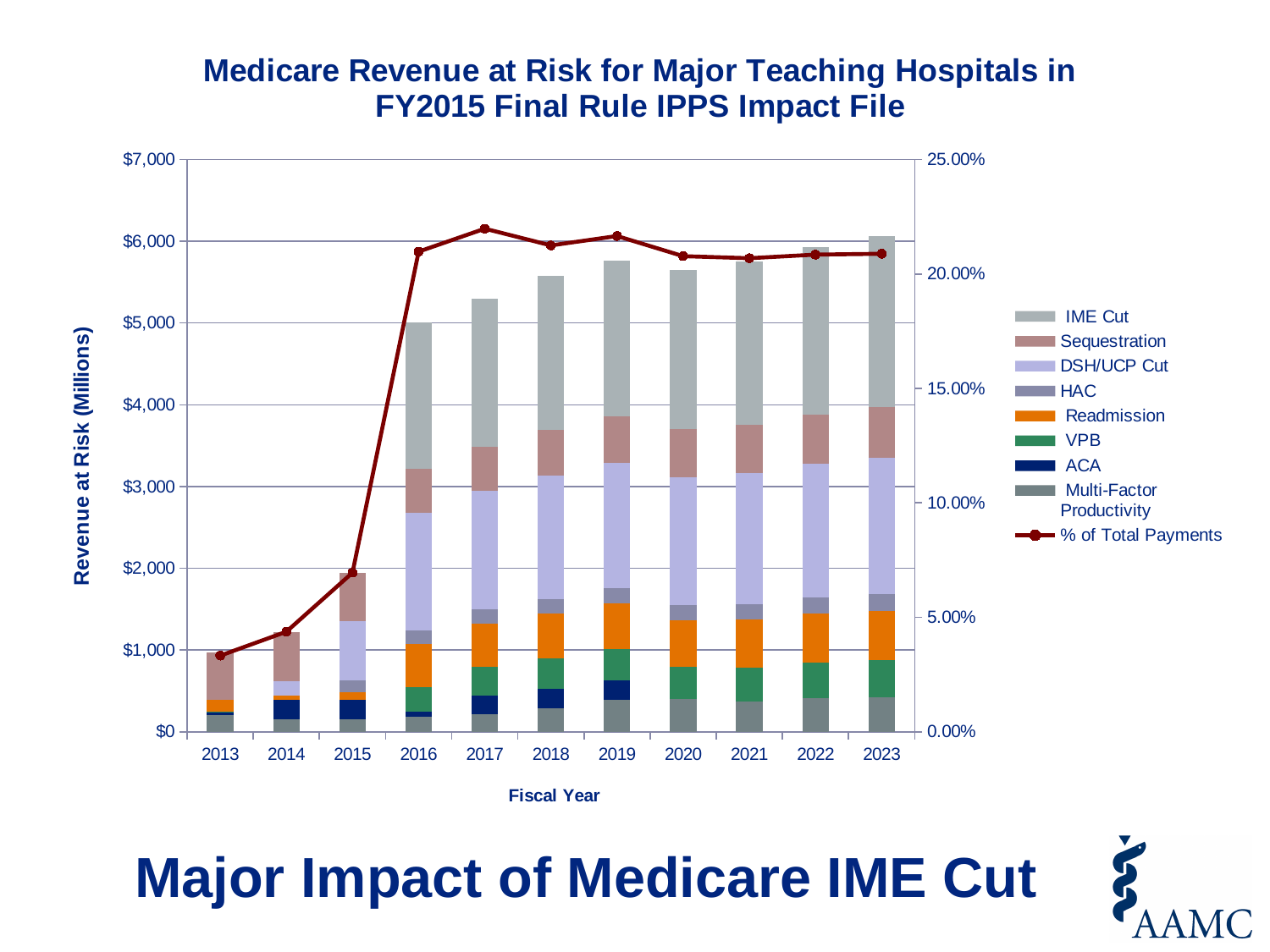
What kind of chart is shown on the slide? A stacked bar chart with a line Does the % of Total Payments line rise or fall from 2013 to 2017? rise Is the total revenue at risk bar for 2015 greater or less than $3,000? less Is the total revenue at risk bar for 2017 greater or less than $5,000? greater Is the % of Total Payments value for 2015 greater or less than 10.00%? less In which fiscal year does the % of Total Payments line reach its highest point? 2017 What is the label of the chart's vertical axis on the left? Revenue at Risk (Millions) Which fiscal year has the larger total revenue at risk bar, 2015 or 2017? 2017 Which fiscal year has the lowest total revenue at risk bar? 2013 How many entries does the chart's legend list? 9 How many fiscal years are shown on the x axis of the chart? 11